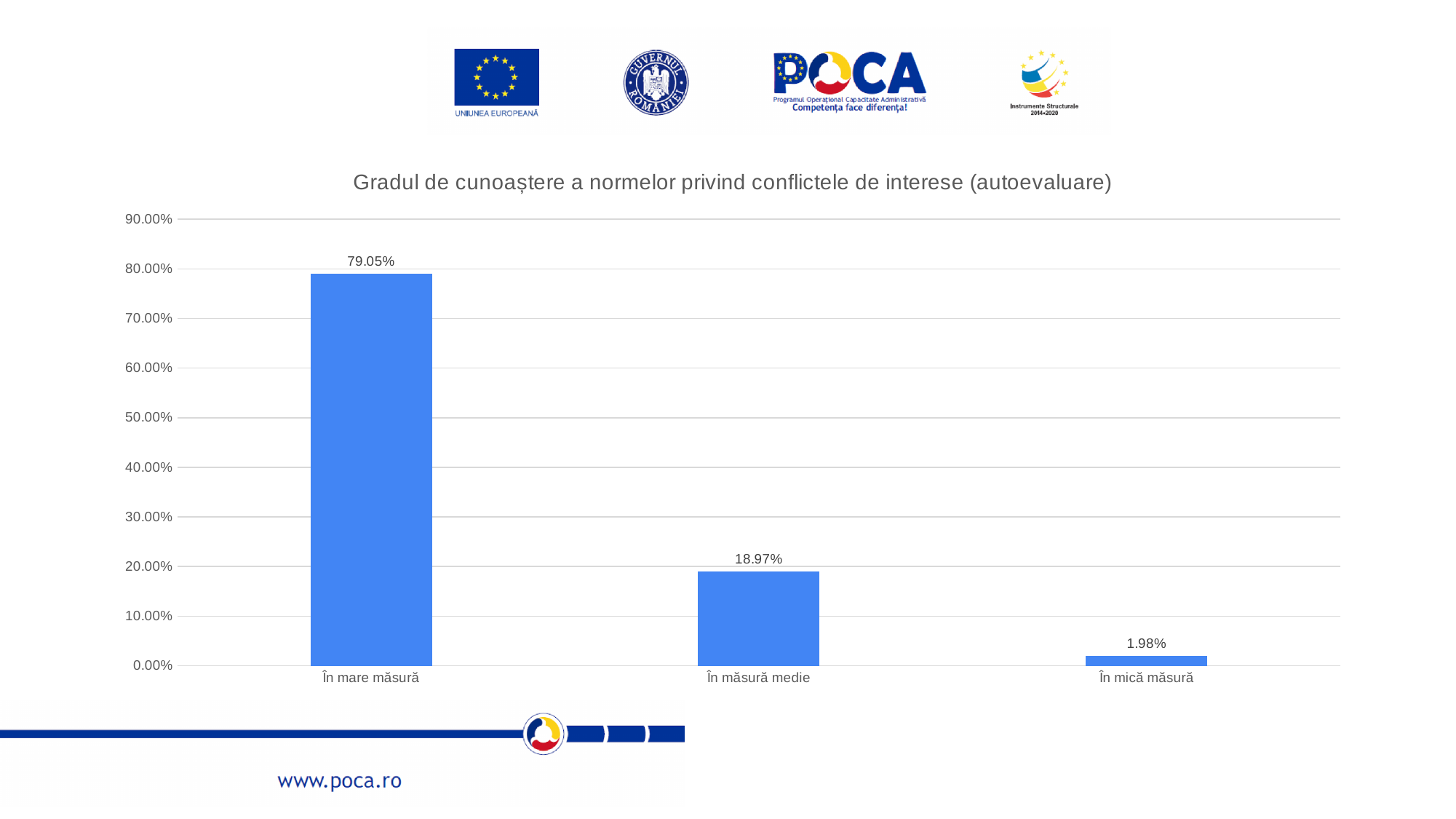
Is the value for "În mare măsură" greater or less than 70.00%? greater Which is larger, the value for "În măsură medie" or the value for "În mică măsură"? În măsură medie What is the value for "În mare măsură"? 79.05% What is the value for "În mică măsură"? 1.98% Which category has the highest value? În mare măsură What is the title of the chart? Gradul de cunoaștere a normelor privind conflictele de interese (autoevaluare) What kind of chart is shown on the slide? bar chart What is the difference between the values for "În măsură medie" and "În mică măsură"? 16.99% What is the value for "În măsură medie"? 18.97% Which category has the lowest value? În mică măsură How many categories are shown on the x axis? 3 What is the difference between the values for "În mare măsură" and "În măsură medie"? 60.08%